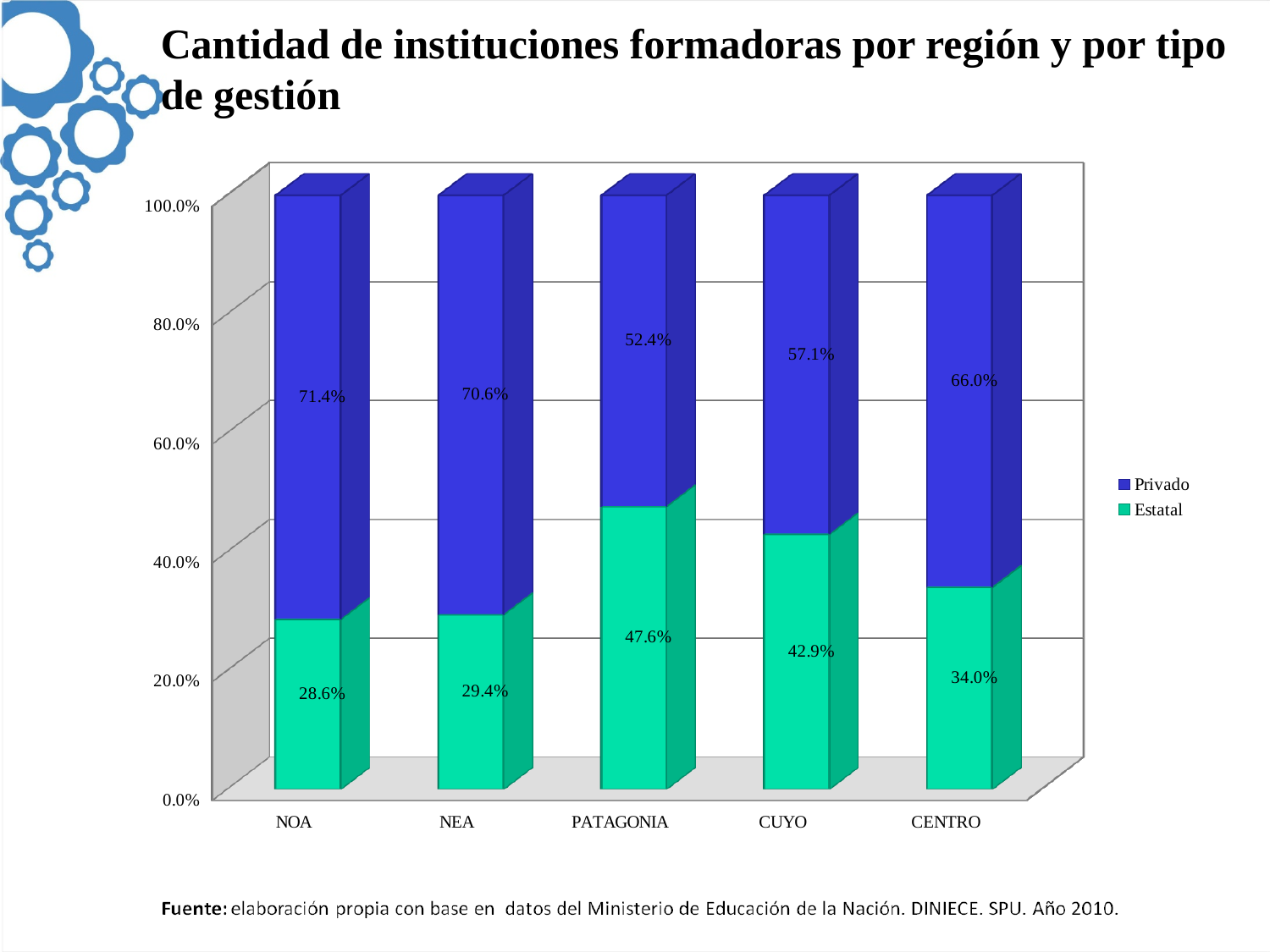
Which is larger, the Estatal value for NEA or the Estatal value for CENTRO? CENTRO Which region has the lowest Estatal share? NOA How many series does the legend list? 2 Which series is shown in blue in the legend? Privado What is the difference between the Privado and Estatal values for CUYO? 14.2% What kind of chart is shown on the slide? Stacked bar chart What is the Estatal value for NOA? 28.6% Which region has the highest Privado share? NOA What is the total of the stacked bar for NEA? 100.0% How many regions are shown on the x axis? 5 What is the Privado value for CENTRO? 66.0% What is the Estatal value for PATAGONIA? 47.6%